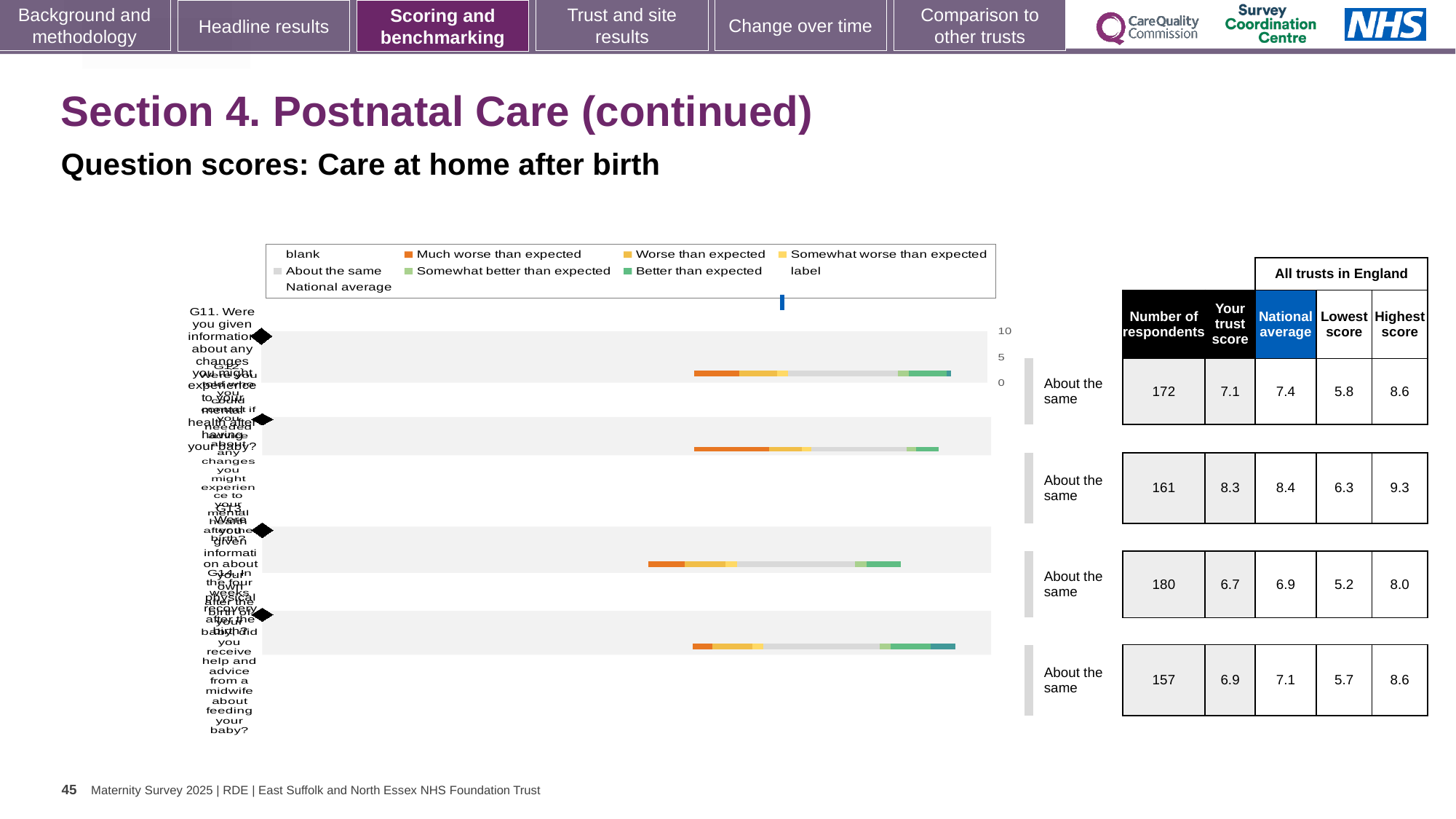
How many horizontal bars are plotted in the chart? 4 In the chart legend, which colour represents 'Much worse than expected'? orange In the table to the right of the chart, what is the national average in the third row? 6.9 In the table to the right of the chart, what is the number of respondents in the first row? 172 What kind of chart is shown on the slide? bar chart In the first row of the table, what is the difference between the national average and the trust score? 0.3 In the table to the right of the chart, which row has the smallest 'Lowest score' value? third row (5.2) What is the highest tick value shown on the chart's axis? 10 In the table to the right of the chart, what is the 'Your trust score' value in the second row? 8.3 In the table to the right of the chart, which row has the largest 'Highest score' value? second row (9.3) In the table to the right of the chart, what is the highest score in the fourth row? 8.6 In the first row of the table, which is larger: the trust score or the national average? national average